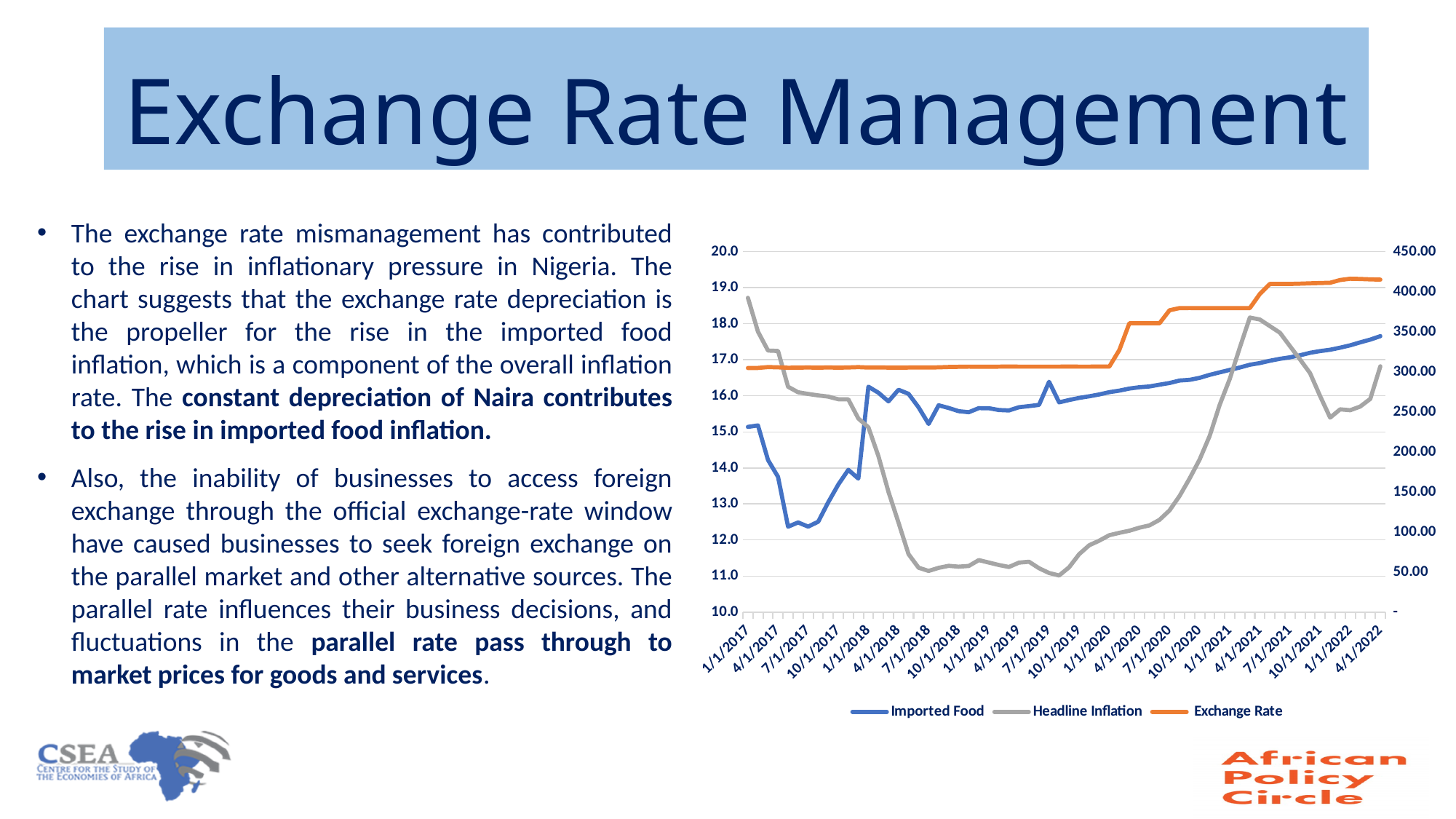
Is the Headline Inflation value at 1/1/2017 greater or less than 18.0? greater At 7/1/2018, which is higher: Imported Food or Headline Inflation? Imported Food Is the Headline Inflation value at 7/1/2018 greater or less than 12.0? less At 1/1/2017, which is higher: Headline Inflation or Imported Food? Headline Inflation Is the Exchange Rate value at 4/1/2022 greater or less than 400.00? greater Which colour is used for the Exchange Rate line? Orange What kind of chart is shown on the slide? Line chart Does the Exchange Rate line generally rise or fall from 1/1/2017 to 4/1/2022? Rise How many series does the chart legend list? 3 Which series are listed in the chart legend? Imported Food, Headline Inflation, Exchange Rate